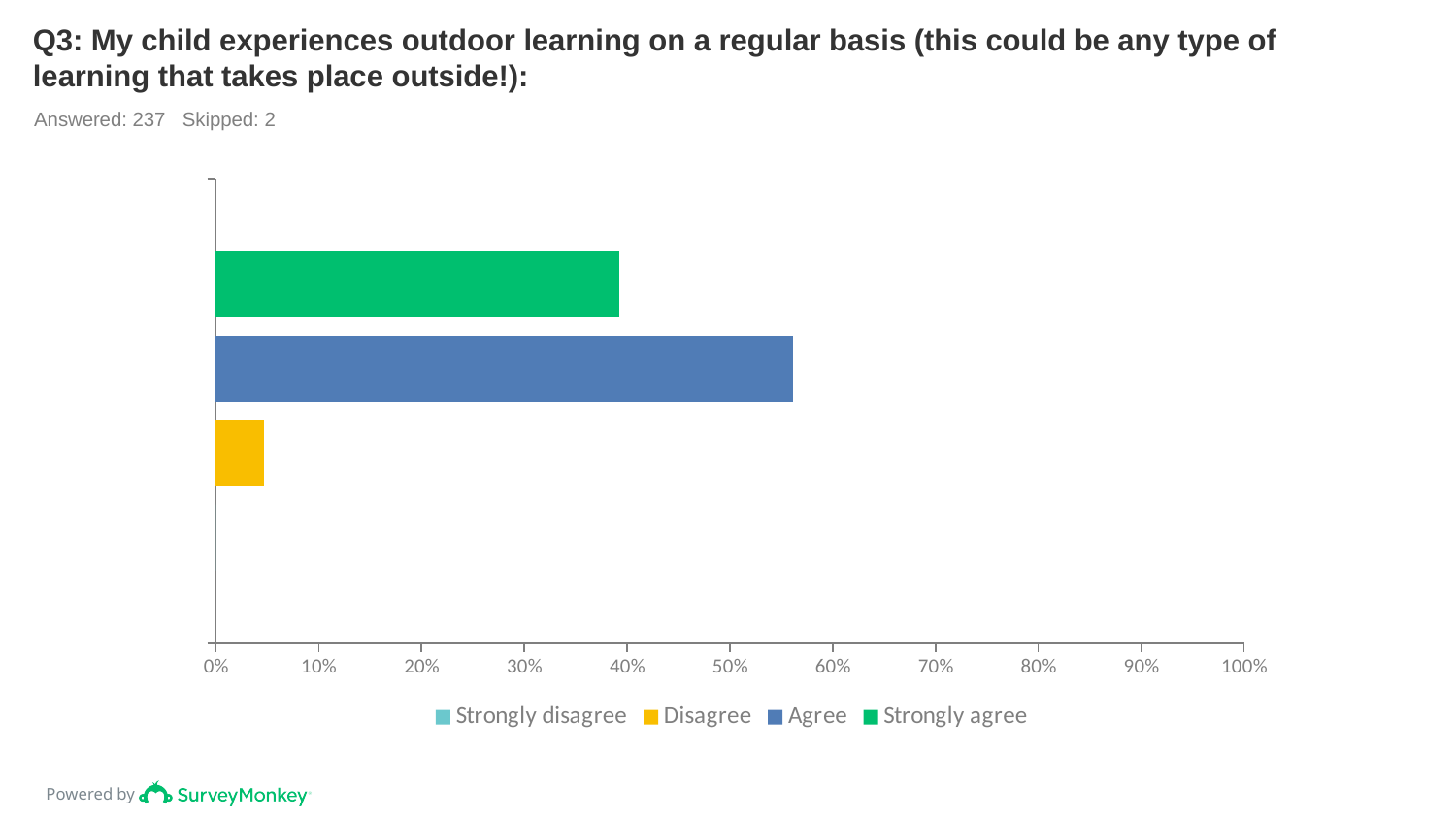
Is the value for Strongly agree greater or less than 30%? greater How many series does the legend list? 4 What colour is the bar for Agree? Blue Which response option has the longest bar? Agree Which is larger, the value for Disagree or the value for Strongly agree? Strongly agree What kind of chart is shown on the slide? Bar chart Is the value for Agree greater or less than 60%? less Is the value for Disagree greater or less than 10%? less Which is larger, the value for Agree or the value for Strongly agree? Agree Which legend entry is shown in green? Strongly agree